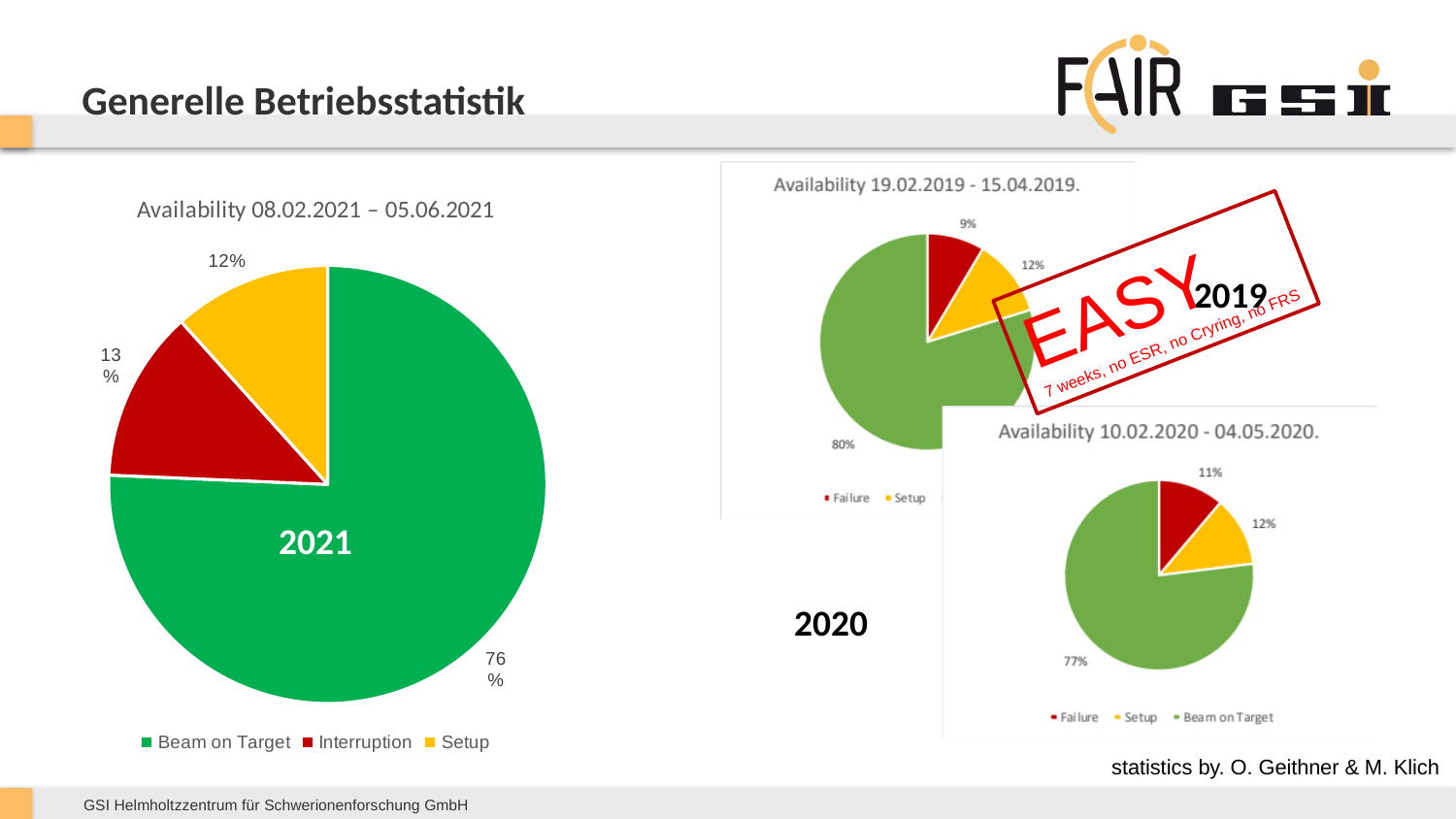
In the 2020 chart (Availability 10.02.2020 - 04.05.2020), what share is Beam on Target? 77% In the 2020 chart (Availability 10.02.2020 - 04.05.2020), what share is Failure? 11% In the 2019 chart (Availability 19.02.2019 - 15.04.2019), what share is the largest (green) slice? 80% In the 2020 chart (Availability 10.02.2020 - 04.05.2020), which is larger, Failure or Setup? Setup In the 2021 chart (Availability 08.02.2021 – 05.06.2021), how many entries does the legend list? 3 What type of chart is the 2021 chart (Availability 08.02.2021 – 05.06.2021)? Pie chart In the 2021 chart (Availability 08.02.2021 – 05.06.2021), what share is Beam on Target? 76% In the 2021 chart (Availability 08.02.2021 – 05.06.2021), what share is Interruption? 13% In the 2019 chart (Availability 19.02.2019 - 15.04.2019), what share is Failure? 9% In the 2021 chart (Availability 08.02.2021 – 05.06.2021), which category has the largest slice? Beam on Target In the 2021 chart (Availability 08.02.2021 – 05.06.2021), what is the difference between the Beam on Target share and the Interruption share? 63% In the 2021 chart (Availability 08.02.2021 – 05.06.2021), what share is Setup? 12%